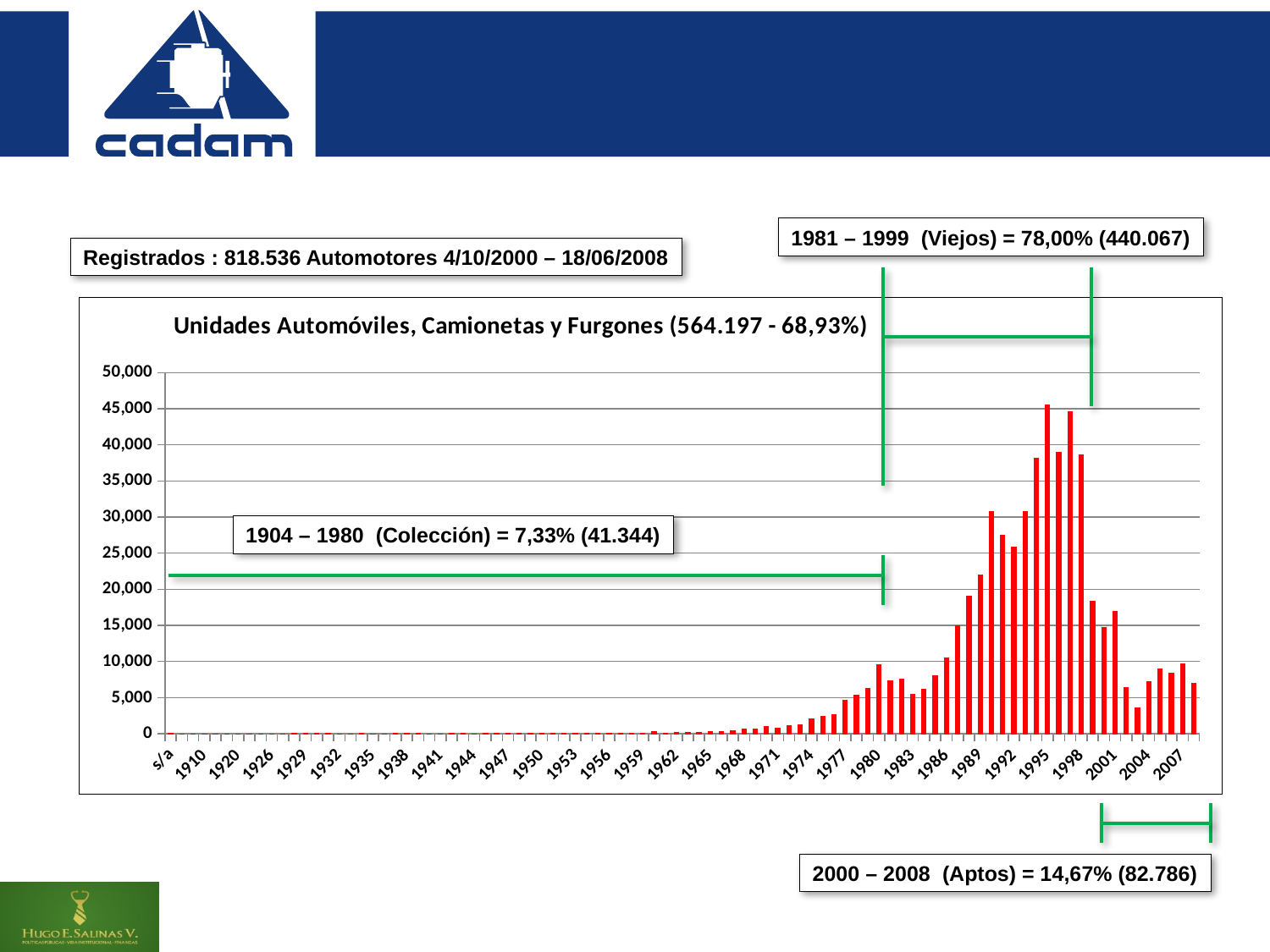
What is the title of the chart? Unidades Automóviles, Camionetas y Furgones (564.197 - 68,93%) Is the value for 2004 greater or less than 5,000? greater What kind of chart is shown on the slide? bar chart What is the highest value shown on the vertical axis? 50,000 Is the value for 1995 greater or less than 40,000? greater Which is larger, the value for 1992 or the value for 1983? 1992 Do the values generally rise or fall from 1977 to 1995? rise Is the value for 1980 greater or less than 5,000? greater Do the values generally rise or fall from 1998 to 2004? fall Which is larger, the value for 2001 or the value for 2007? 2001